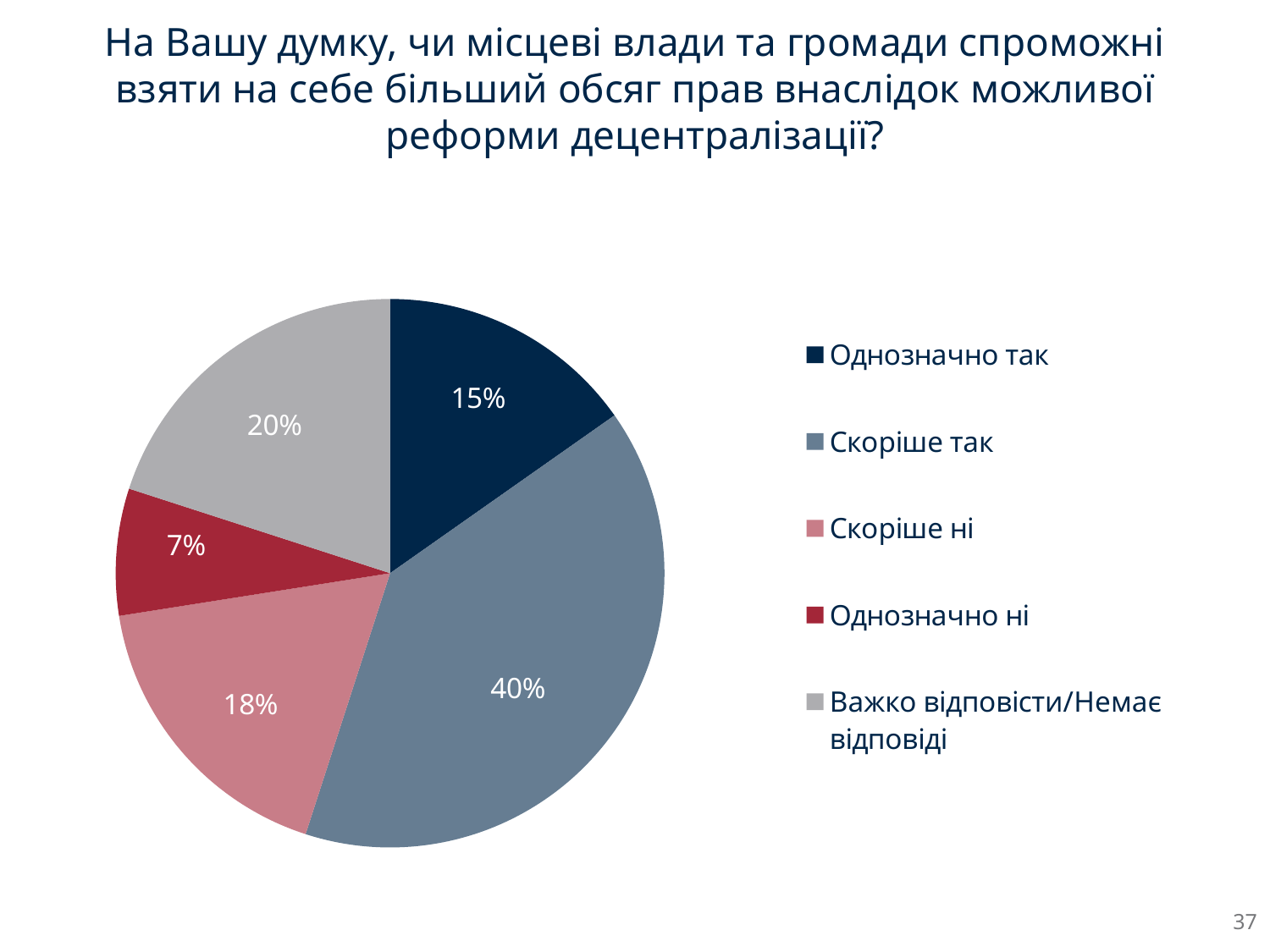
Which answer option has the smallest slice of the pie? Однозначно ні What share of respondents answered "Скоріше так"? 40% What share of respondents answered "Важко відповісти/Немає відповіді"? 20% What is the difference in percentage points between "Скоріше так" and "Скоріше ні"? 22 What share of respondents answered "Скоріше ні"? 18% Which is larger: the share for "Однозначно так" or the share for "Важко відповісти/Немає відповіді"? Важко відповісти/Немає відповіді What share of respondents answered "Однозначно так"? 15% Which answer option has the largest slice of the pie? Скоріше так What colour is the slice for "Однозначно ні"? dark red How many answer options does the legend list? 5 What share of respondents answered "Однозначно ні"? 7% What type of chart is shown on the slide? pie chart